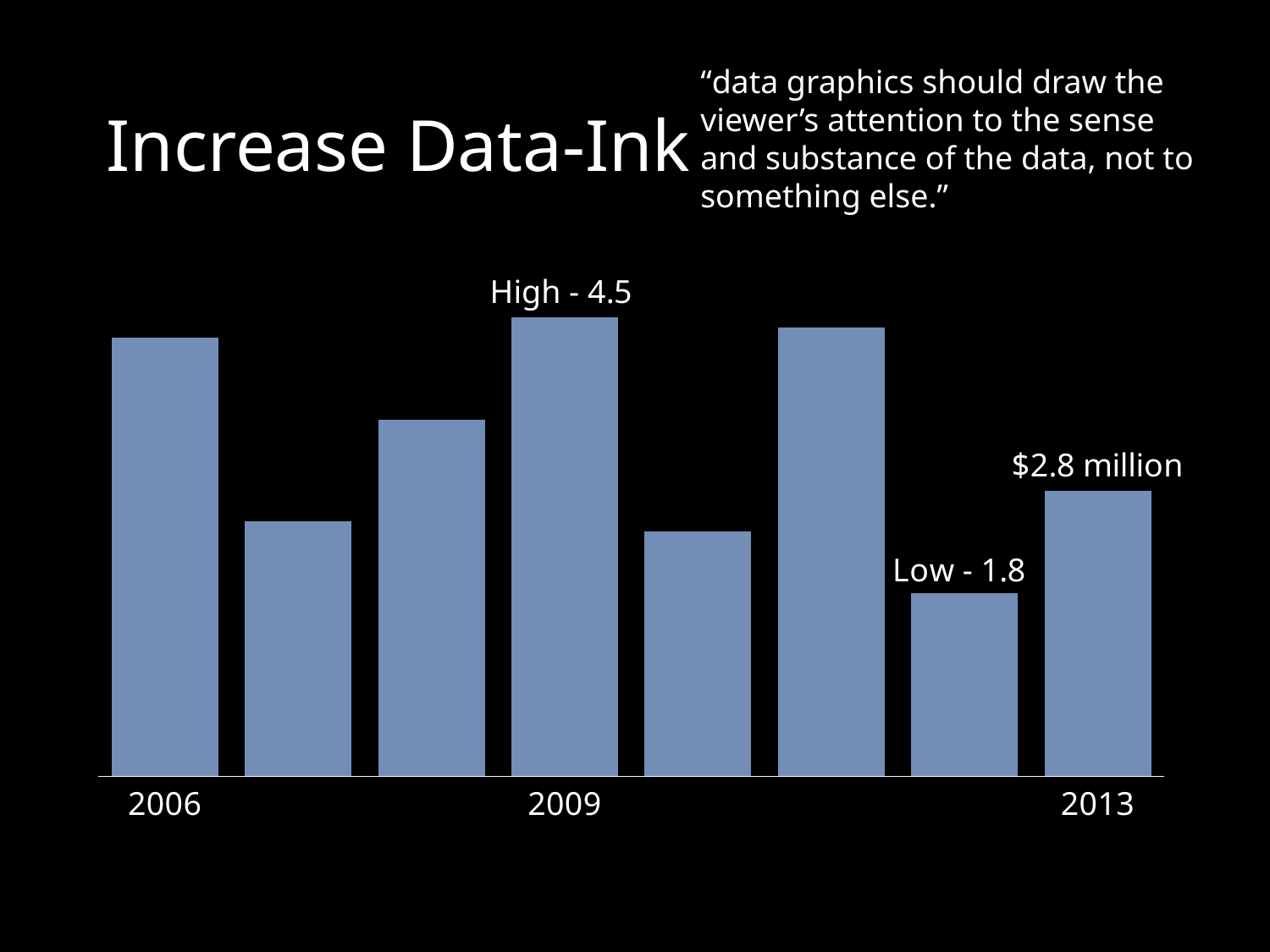
What is the first year label shown on the x axis of the chart? 2006 What is the difference between the labelled high value and the labelled low value? 2.7 What is the value labelled on the bar for 2013? $2.8 million Which bar is taller, the one for 2006 or the one immediately to its right? 2006 How many bars are plotted in the chart? 8 Which year has the highest bar in the chart? 2009 What is the value labelled as the low point in the chart? 1.8 What is the title of the slide containing the chart? Increase Data-Ink What kind of chart is shown on the slide? bar chart Which bar is taller, the one for 2013 or the one immediately to its left (labelled Low - 1.8)? 2013 Which bar is taller, the one immediately to the left of 2009 or the one immediately to the right of 2009? the one to the left of 2009 What is the value labelled as the high point in the chart? 4.5